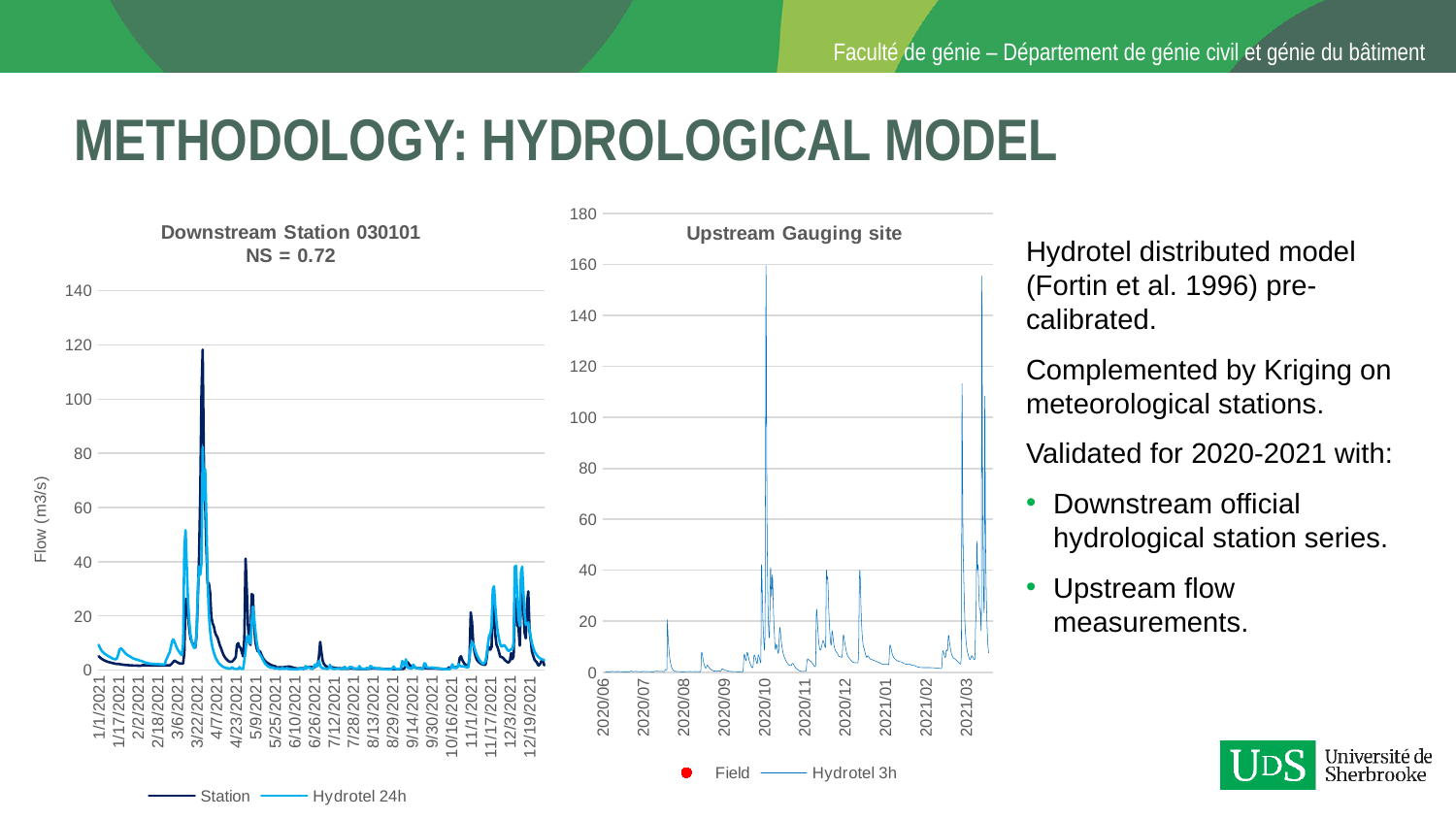
In the Upstream Gauging site chart, what are the two series named in the legend? Field and Hydrotel 3h In the Downstream Station 030101 chart, what are the two series named in the legend? Station and Hydrotel 24h What NS value is shown in the title of the Downstream Station 030101 chart? NS = 0.72 In the Upstream Gauging site chart, is the Hydrotel 3h value at 2020/07 greater or less than 20? less In the Upstream Gauging site chart, is the highest peak of the Hydrotel 3h series, near 2020/10, greater or less than 140? greater What kind of chart is the Upstream Gauging site chart? line chart How many series does the legend of the Upstream Gauging site chart list? 2 In the Downstream Station 030101 chart, is the Station value on 1/1/2021 greater or less than 20? less What kind of chart is the Downstream Station 030101 chart? line chart How many series does the legend of the Downstream Station 030101 chart list? 2